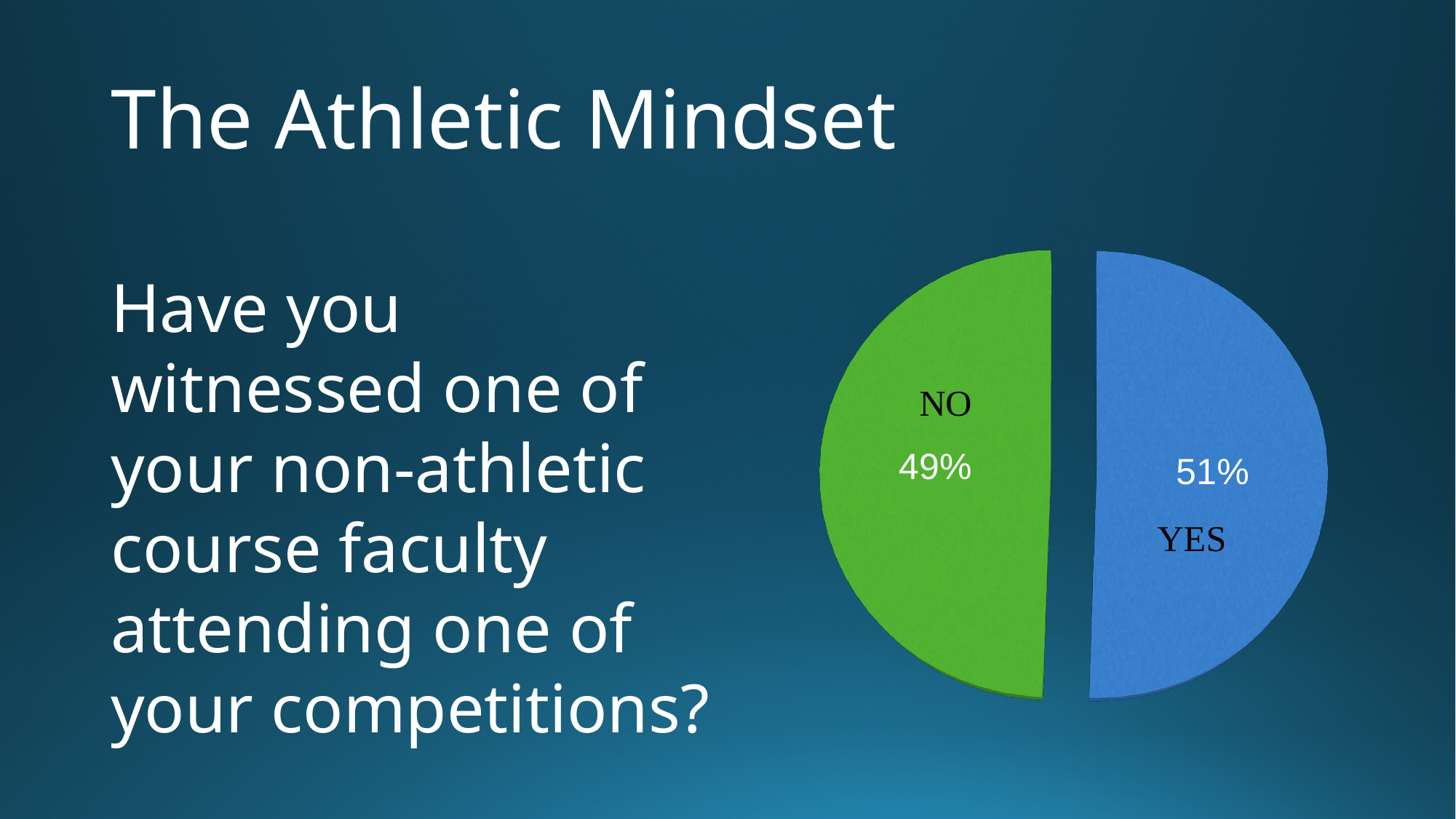
What share of the pie does the NO slice represent? 49% Which slice of the pie chart is the smallest? NO What is the difference in percentage points between the YES and NO slices? 2 Which slice of the pie chart is the largest? YES What percentage of the pie chart is labelled NO? 49% How many slices does the pie chart have? 2 What kind of chart is shown on the slide? pie chart What colour is the NO slice of the pie chart? green What colour is the YES slice of the pie chart? blue Which is larger in the pie chart, YES or NO? YES What percentage of the pie chart is labelled YES? 51%